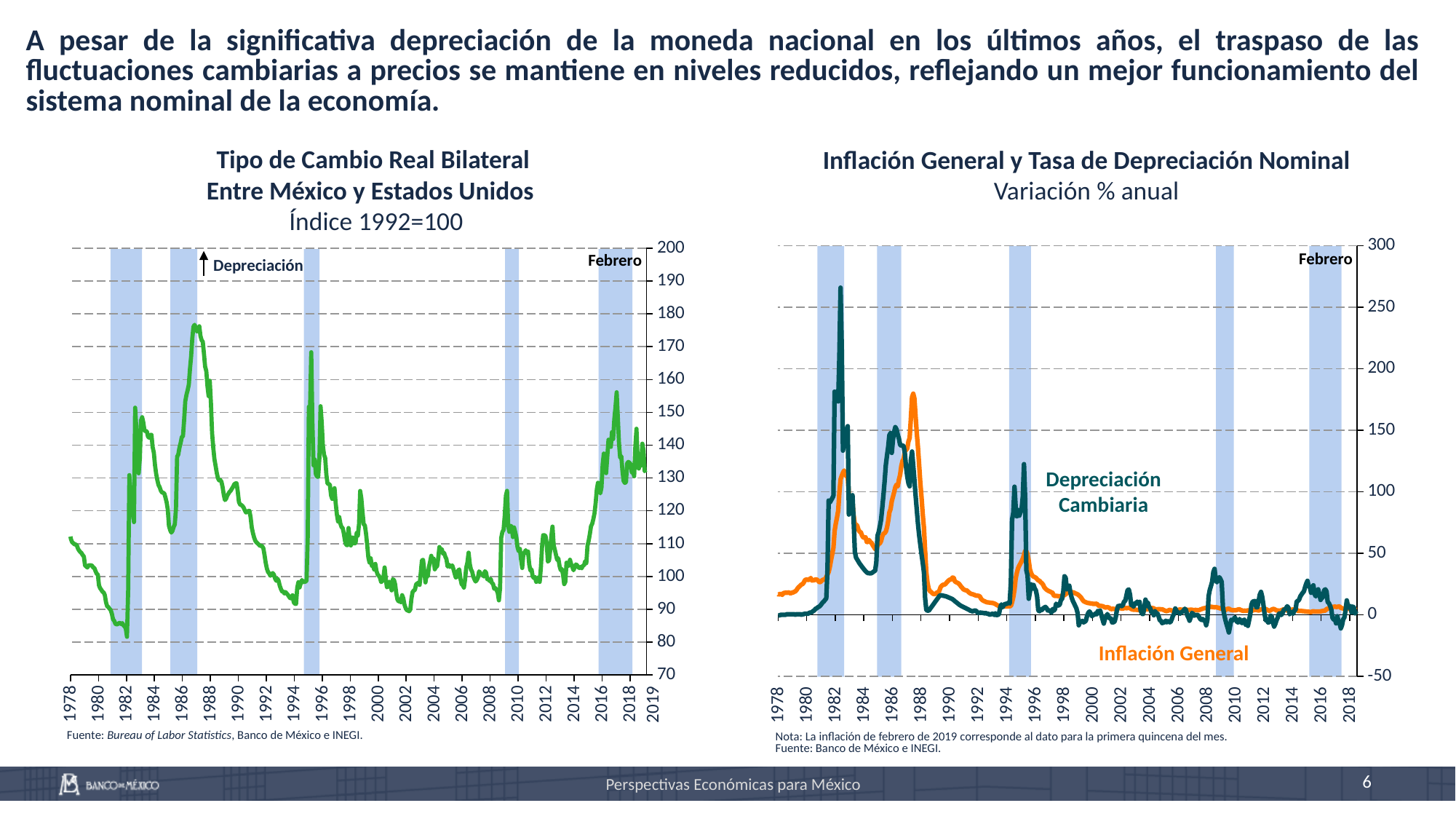
What kind of chart is the 'Tipo de Cambio Real Bilateral Entre México y Estados Unidos' chart? line chart In the 'Inflación General y Tasa de Depreciación Nominal' chart, what are the names of the two series? Depreciación Cambiaria and Inflación General In the 'Tipo de Cambio Real Bilateral' chart, what is the base year of the index shown in the subtitle? 1992=100 In the 'Inflación General y Tasa de Depreciación Nominal' chart, does Inflación General generally rise or fall from the late 1980s to 2018? fall What kind of chart is the 'Inflación General y Tasa de Depreciación Nominal' chart? line chart In the 'Inflación General y Tasa de Depreciación Nominal' chart, is the peak of Inflación General around 1987 greater or less than 150? greater In the 'Inflación General y Tasa de Depreciación Nominal' chart, is the peak of Depreciación Cambiaria around 1982 greater or less than 250? greater In the 'Tipo de Cambio Real Bilateral' chart, is the peak value around 1987 greater or less than 160? greater In the 'Inflación General y Tasa de Depreciación Nominal' chart, how many series are plotted? 2 In the 'Inflación General y Tasa de Depreciación Nominal' chart, which series reaches the higher peak value over the whole period? Depreciación Cambiaria